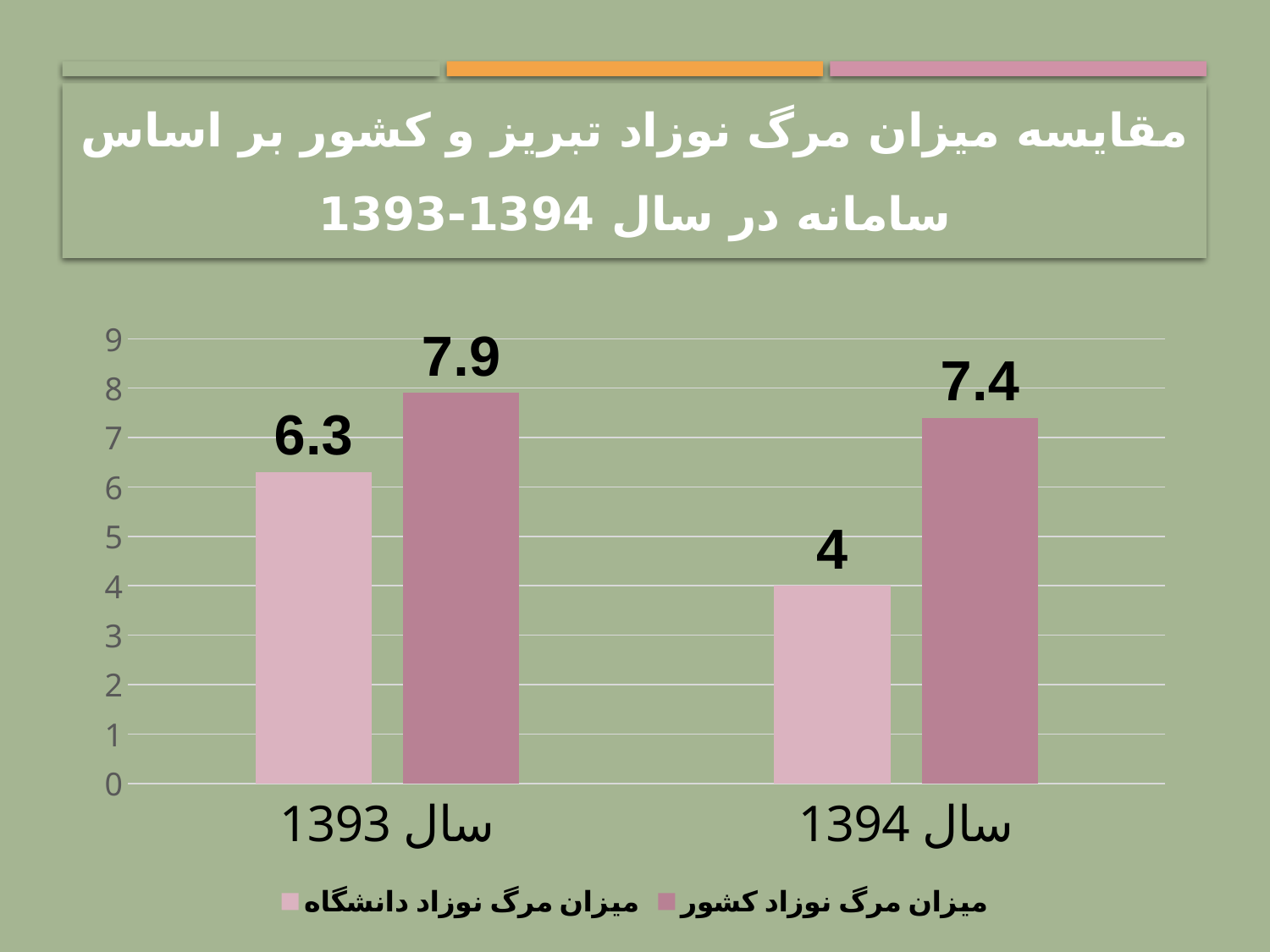
How many categories are shown on the x axis? 2 What kind of chart is shown on the slide? Bar chart How many series does the legend list? 2 Which bar has the highest value on the chart? میزان مرگ نوزاد کشور for سال 1393 (7.9) What is the value of میزان مرگ نوزاد دانشگاه for سال 1393? 6.3 Which is larger: میزان مرگ نوزاد دانشگاه for سال 1393 or for سال 1394? سال 1393 What is the value of میزان مرگ نوزاد کشور for سال 1394? 7.4 What is the difference between میزان مرگ نوزاد کشور and میزان مرگ نوزاد دانشگاه for سال 1393? 1.6 What is the value of میزان مرگ نوزاد دانشگاه for سال 1394? 4 Which bar has the lowest value on the chart? میزان مرگ نوزاد دانشگاه for سال 1394 (4) What is the difference between میزان مرگ نوزاد کشور and میزان مرگ نوزاد دانشگاه for سال 1394? 3.4 What is the value of میزان مرگ نوزاد کشور for سال 1393? 7.9